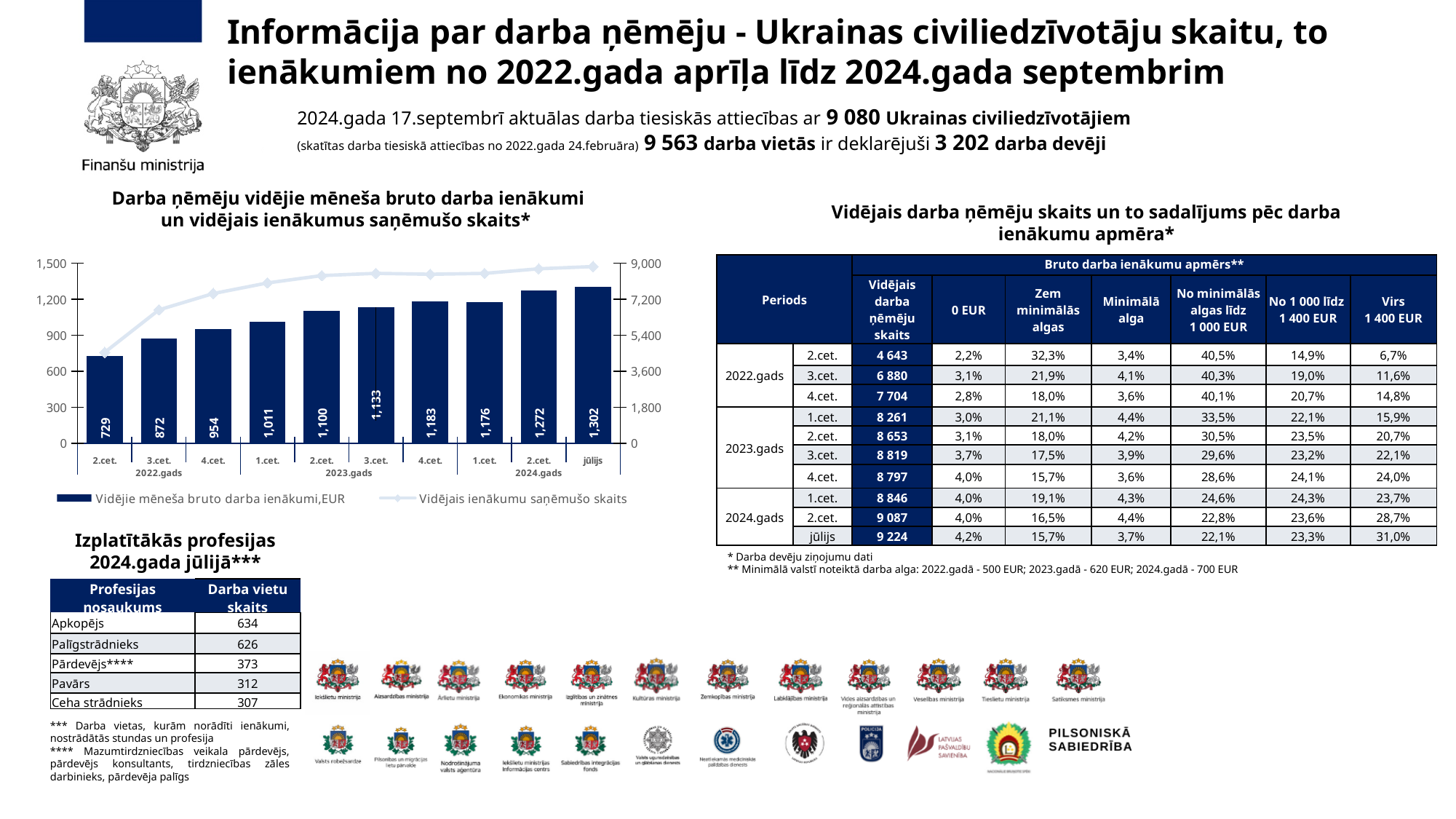
Is the value of the line series 'Vidējais ienākumu saņēmušo skaits' for 2.cet. 2022.gads greater or less than 5,400? less What is the value of the bar for 3.cet. 2022.gads in the chart 'Darba ņēmēju vidējie mēneša bruto darba ienākumi un vidējais ienākumus saņēmušo skaits'? 872 Which period has the lowest bar in the chart? 2.cet. 2022.gads How many periods are shown on the x axis of the chart? 10 What is the value of the bar for jūlijs 2024.gads in the chart? 1,302 What is the value of the bar for 4.cet. 2023.gads in the chart? 1,183 Which period has the highest bar in the chart? jūlijs 2024.gads How many series does the chart's legend list? 2 Which bar is larger: 4.cet. 2023.gads or 1.cet. 2024.gads? 4.cet. 2023.gads What is the difference between the bar values for 2.cet. 2024.gads and 1.cet. 2024.gads? 96 What is the overall trend of the bar values from 2.cet. 2022.gads to jūlijs 2024.gads? Rising Is the value of the line series 'Vidējais ienākumu saņēmušo skaits' for jūlijs 2024.gads greater or less than 7,200? greater